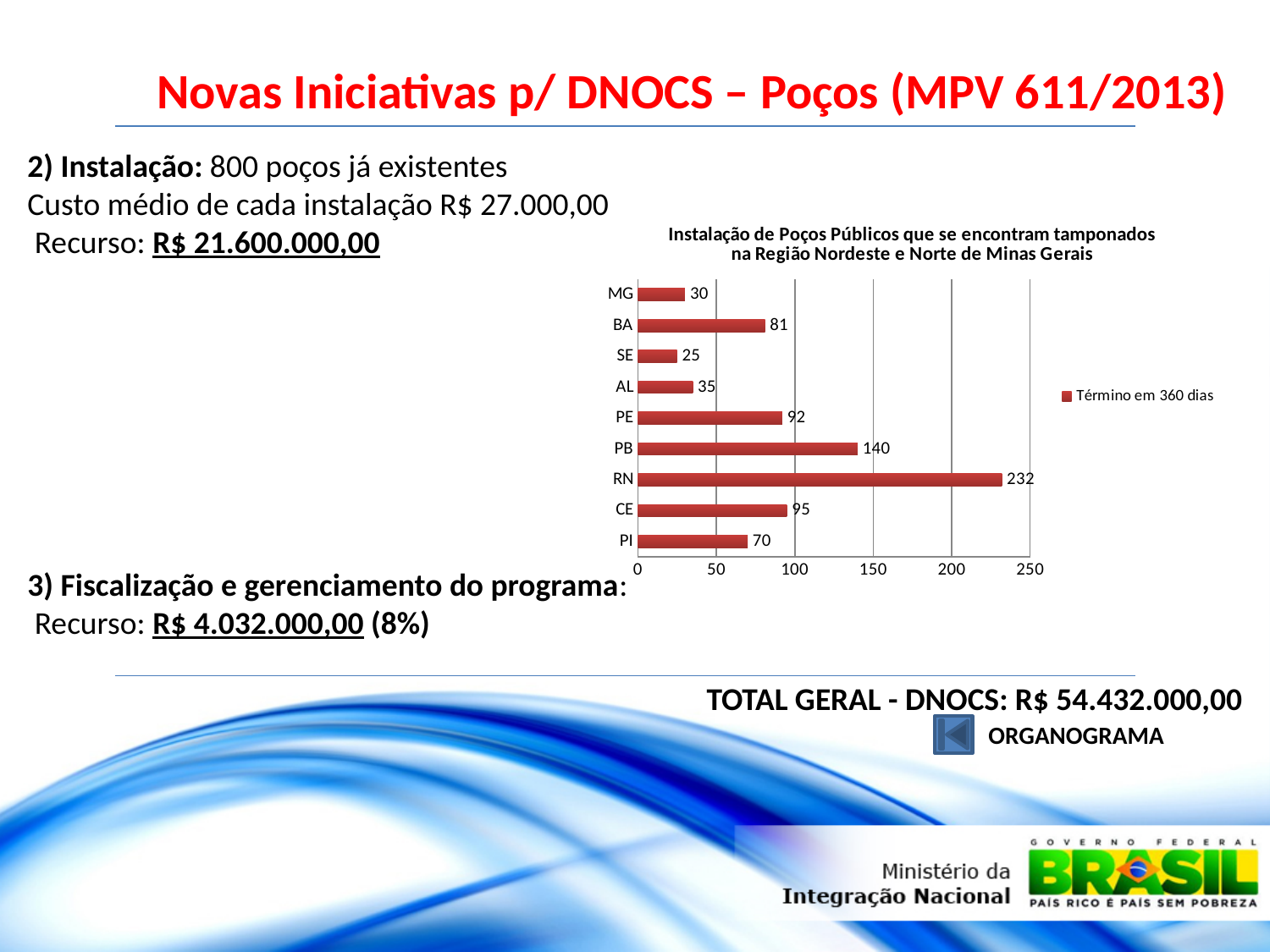
How many states are shown in the chart? 9 Is the value for BA greater or less than 100? less What is the legend entry of the chart? Término em 360 dias How many series does the legend list? 1 Which state has the lowest value in the chart? SE What is the value for RN in the chart? 232 What is the value for SE in the chart? 25 What kind of chart is shown on the slide? bar chart Which is larger, the value for CE or the value for PE? CE What is the value for PB in the chart? 140 Which state has the highest value in the chart? RN What is the difference between the values for RN and PB? 92